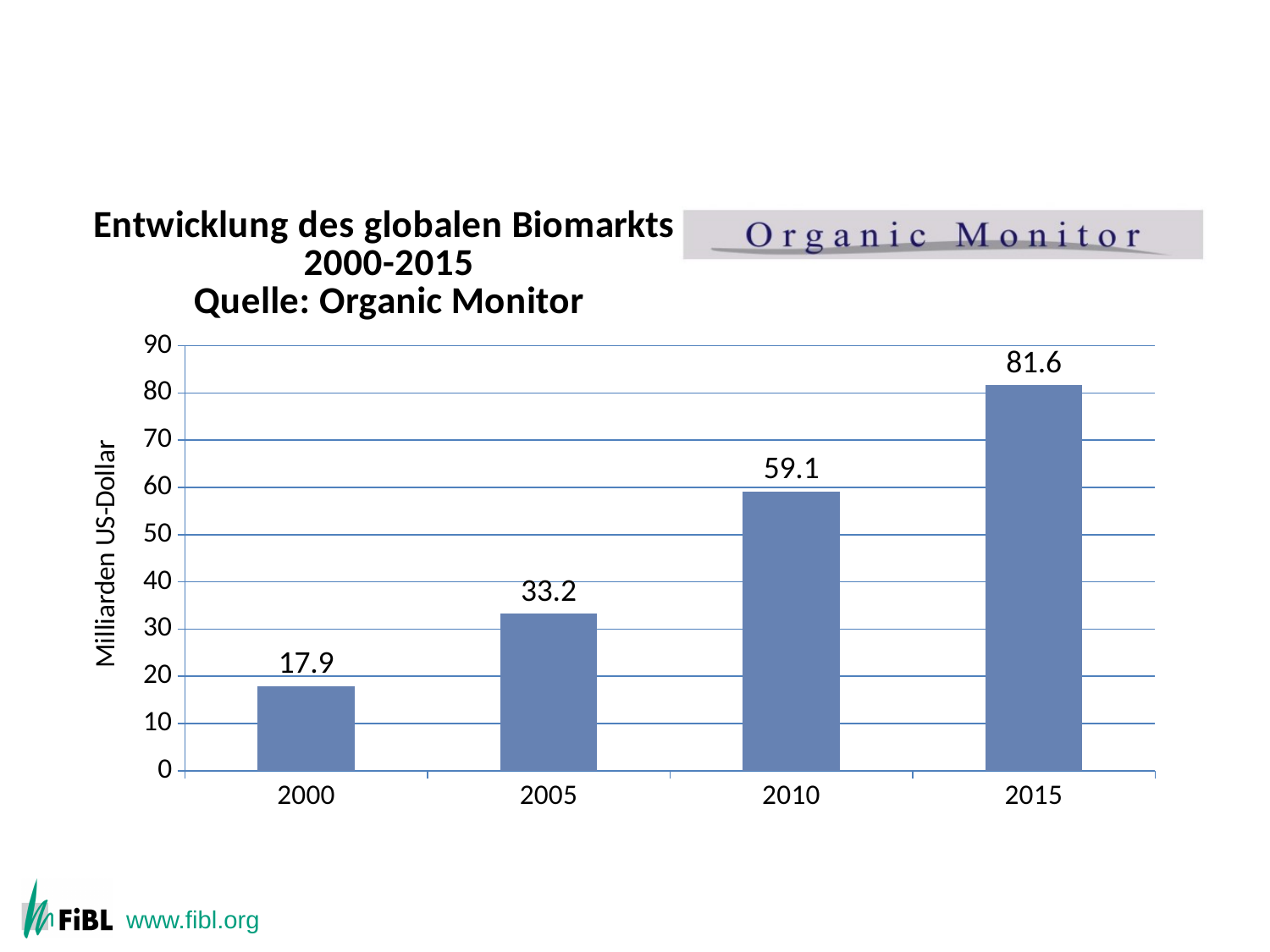
What kind of chart is shown? bar chart What is the difference between the values for 2005 and 2000? 15.3 Do the values rise or fall from 2000 to 2015? rise Which year has the highest value? 2015 Is the value for 2005 greater or less than 30? greater How many years are shown on the x axis? 4 What is the value for 2000? 17.9 Which is larger, the value for 2005 or the value for 2010? 2010 What is the value for 2010? 59.1 What is the difference between the values for 2015 and 2010? 22.5 Which year has the lowest value? 2000 What is the value for 2015? 81.6